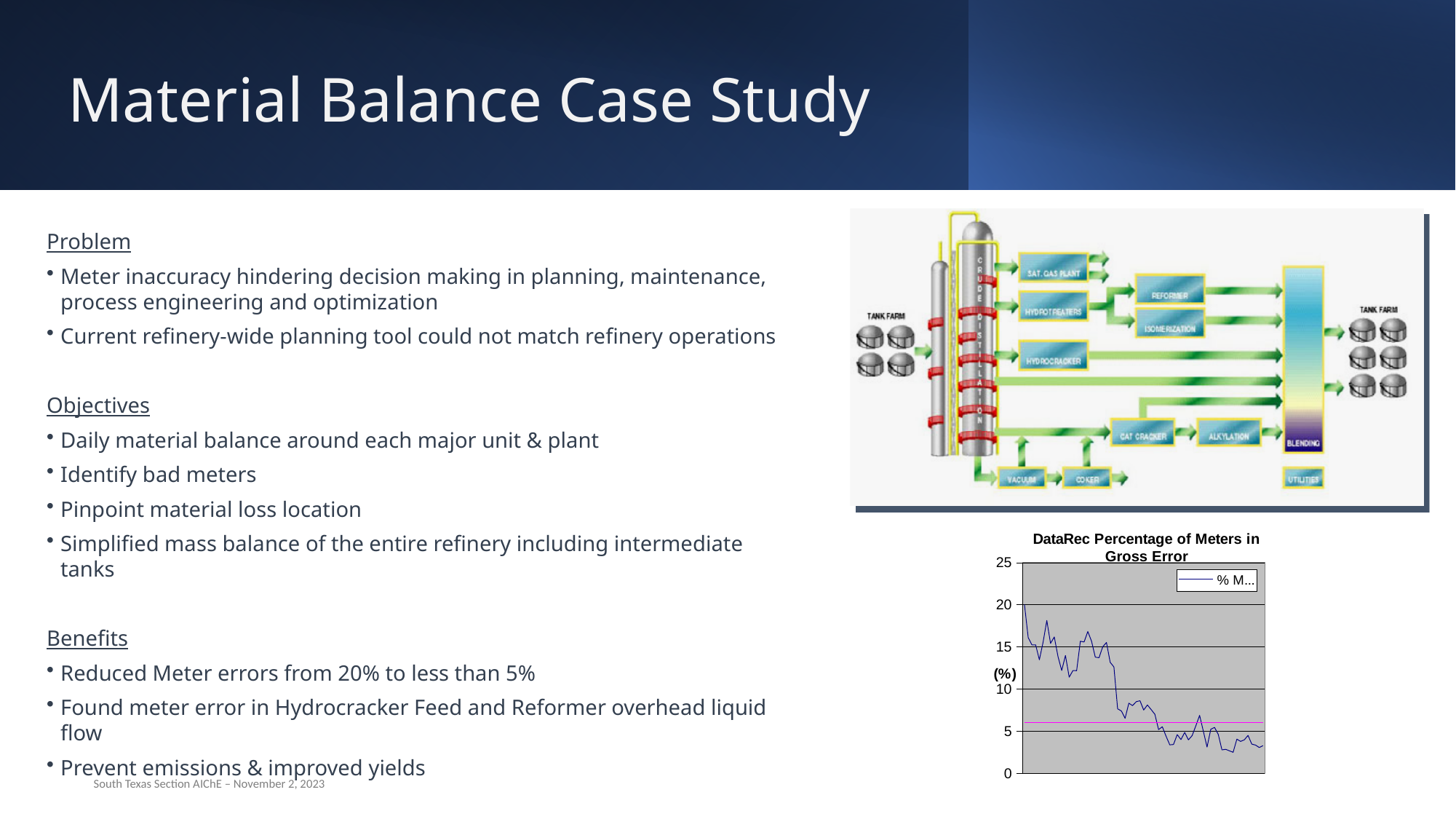
In the "DataRec Percentage of Meters in Gross Error" chart, is the value at the start of the series greater or less than 15? greater Do the values in the "DataRec Percentage of Meters in Gross Error" chart rise or fall along the x axis overall? fall What is the maximum value shown on the y axis of the "DataRec Percentage of Meters in Gross Error" chart? 25 How many series does the legend of the "DataRec Percentage of Meters in Gross Error" chart list? 1 In the "DataRec Percentage of Meters in Gross Error" chart, is the lowest value of the series greater or less than 5? less In the "DataRec Percentage of Meters in Gross Error" chart, is the value at the end of the series greater or less than 5? less What is the title of the chart on the slide? DataRec Percentage of Meters in Gross Error What kind of chart is the "DataRec Percentage of Meters in Gross Error" chart? line chart